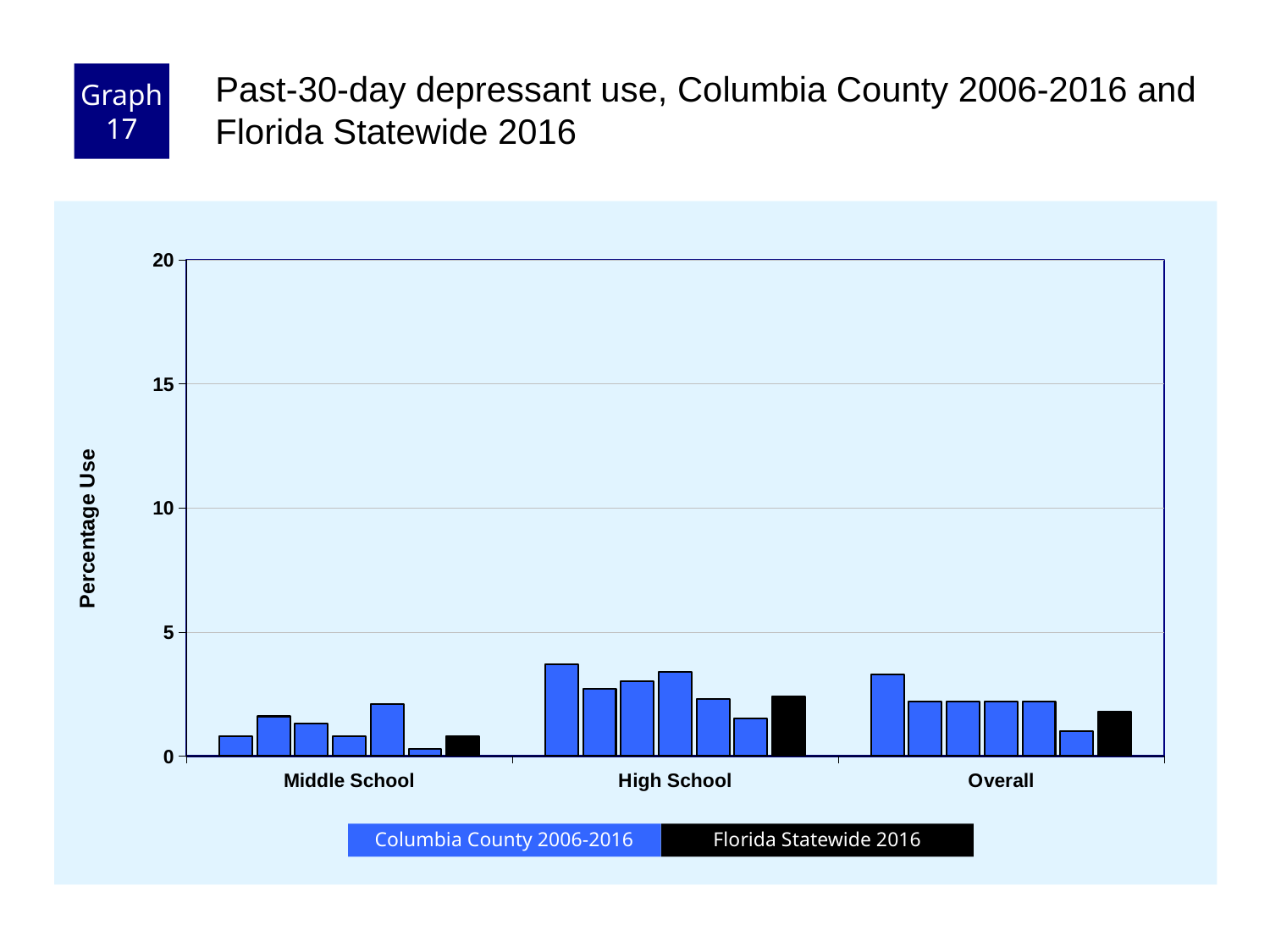
Which category has the lowest Florida Statewide 2016 value? Middle School Which category has the highest Florida Statewide 2016 value? High School How many categories are shown on the x axis? 3 What is the label on the y axis? Percentage Use Is the Florida Statewide 2016 value for High School greater or less than 5? less Which is larger, the Florida Statewide 2016 value for High School or for Middle School? High School What kind of chart is shown on the slide? bar chart Is the Florida Statewide 2016 value for Middle School greater or less than 5? less Is the highest Columbia County 2006-2016 bar for High School greater or less than 5? less What is the title of the chart? Past-30-day depressant use, Columbia County 2006-2016 and Florida Statewide 2016 How many series does the legend list? 2 Which is larger, the Florida Statewide 2016 value for Overall or for Middle School? Overall